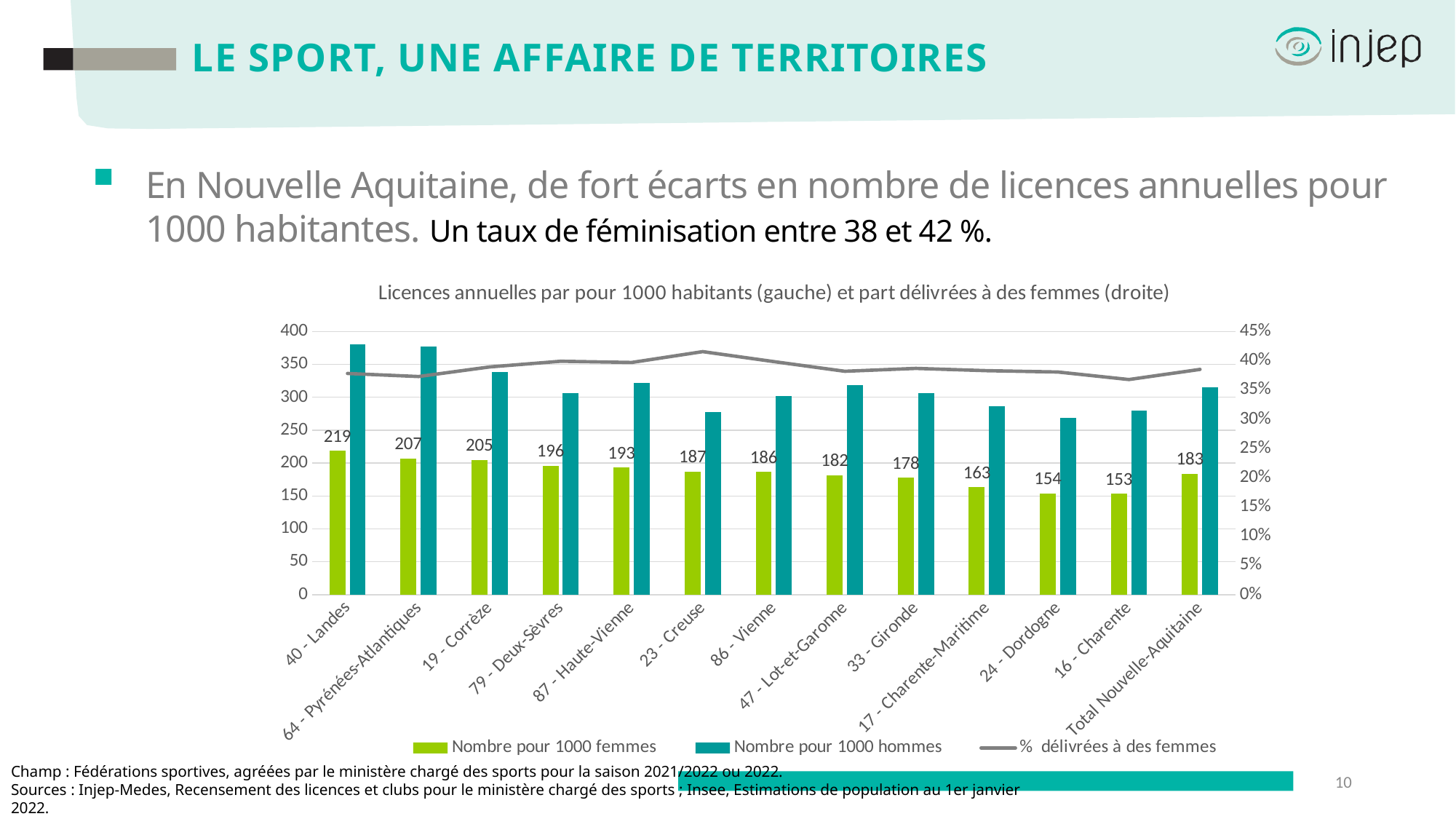
Which category has the highest value for 'Nombre pour 1000 femmes'? 40 - Landes How many series does the legend list? 3 What is the difference between the 'Nombre pour 1000 femmes' values for 40 - Landes and 16 - Charente? 66 Which has a larger 'Nombre pour 1000 femmes' value, 19 - Corrèze or 24 - Dordogne? 19 - Corrèze Is the 'Nombre pour 1000 hommes' value for 24 - Dordogne greater or less than 300? less Which series is plotted as a line rather than bars? % délivrées à des femmes What is the value of 'Nombre pour 1000 femmes' for 17 - Charente-Maritime? 163 What is the value of 'Nombre pour 1000 femmes' for 40 - Landes? 219 Which category has the lowest value for 'Nombre pour 1000 femmes'? 16 - Charente Is the 'Nombre pour 1000 hommes' value for 40 - Landes greater or less than 350? greater What is the value of 'Nombre pour 1000 femmes' for Total Nouvelle-Aquitaine? 183 How many categories are shown on the x axis? 13